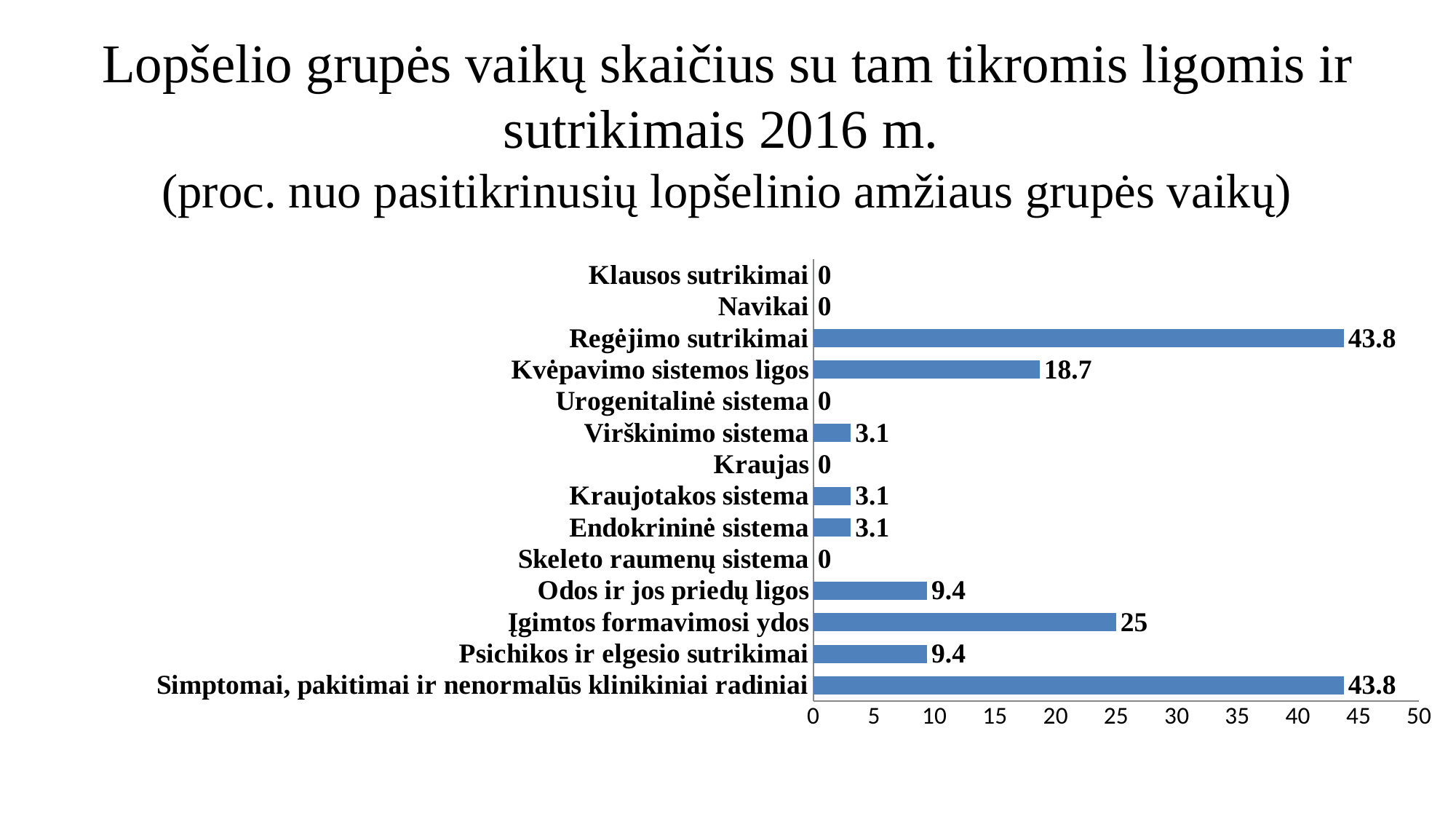
What is the value for Įgimtos formavimosi ydos? 25 What is the value for Odos ir jos priedų ligos? 9.4 What is the value for Kvėpavimo sistemos ligos? 18.7 What kind of chart is shown on the slide? bar chart What is the value for Navikai? 0 What is the difference between the values for Regėjimo sutrikimai and Kvėpavimo sistemos ligos? 25.1 What is the maximum value shown on the horizontal axis? 50 Which is larger, the value for Įgimtos formavimosi ydos or the value for Kvėpavimo sistemos ligos? Įgimtos formavimosi ydos What is the value for Regėjimo sutrikimai? 43.8 What is the highest value shown in the chart? 43.8 How many categories are shown in the chart? 14 What is the difference between the values for Įgimtos formavimosi ydos and Psichikos ir elgesio sutrikimai? 15.6